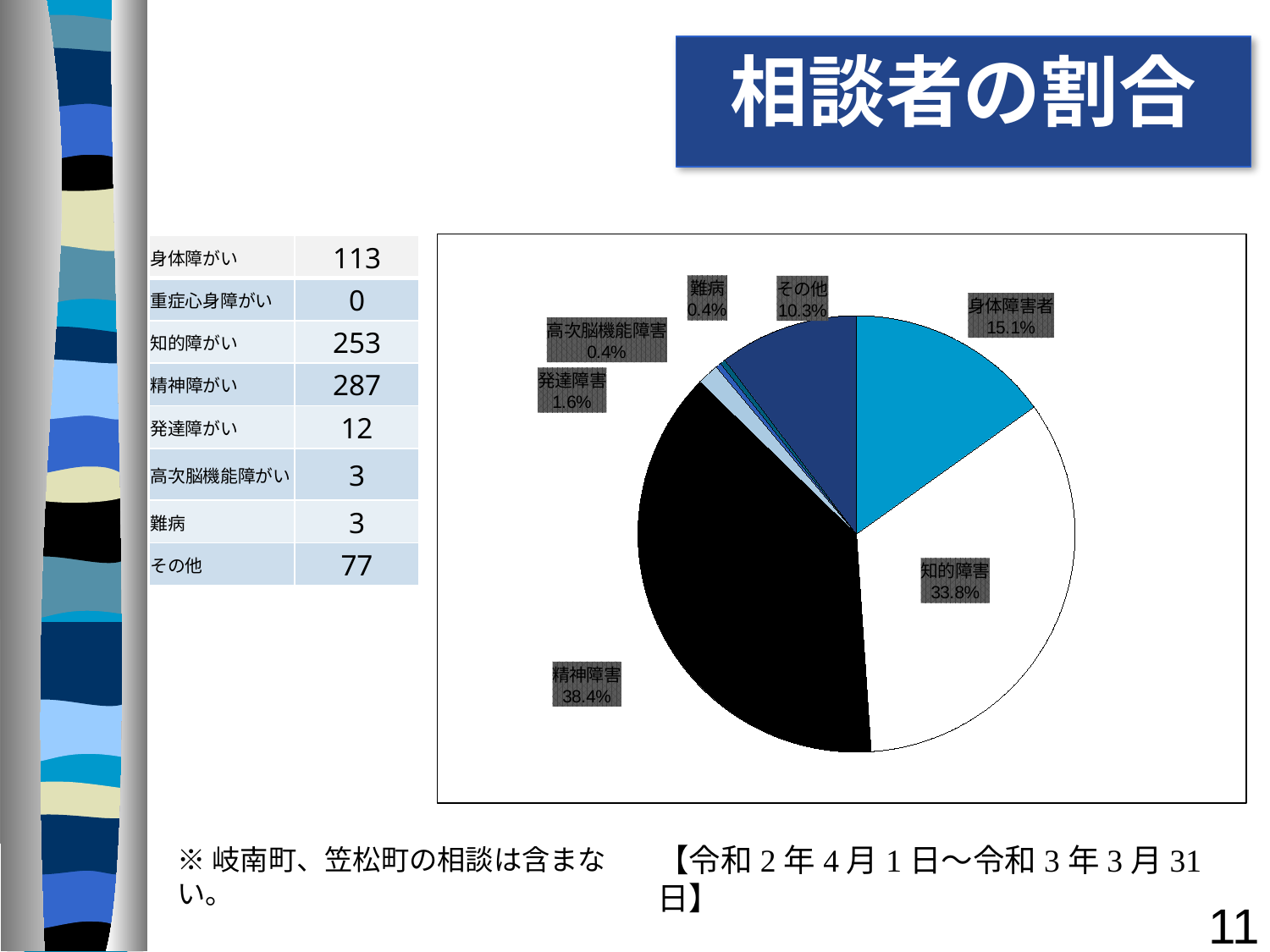
What kind of chart is shown on the slide? pie chart What is the title shown at the top of the slide? 相談者の割合 Which category has the largest slice in the pie chart? 精神障害 What percentage does the 発達障害 slice represent in the pie chart? 1.6% How many labeled slices does the pie chart have? 7 Which slice is larger in the pie chart, 身体障害者 or その他? 身体障害者 What percentage does the 知的障害 slice represent in the pie chart? 33.8% What percentage does the 身体障害者 slice represent in the pie chart? 15.1% What percentage does the その他 slice represent in the pie chart? 10.3% What percentage does the 難病 slice represent in the pie chart? 0.4% What is the difference in percentage points between the 精神障害 slice and the 知的障害 slice? 4.6 What percentage does the 精神障害 slice represent in the pie chart? 38.4%